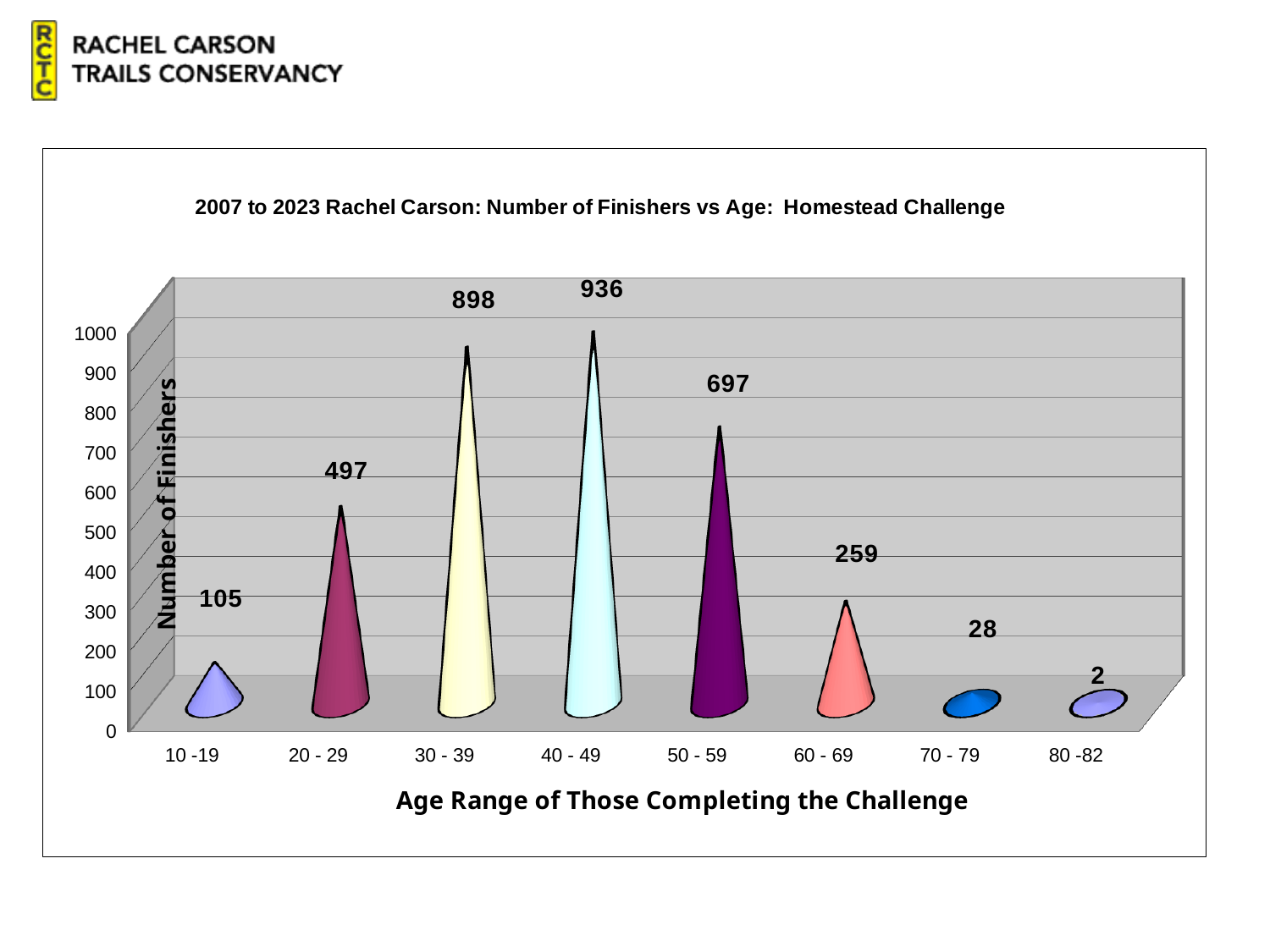
Do the number of finishers rise or fall from the 40 - 49 age range to the 80 -82 age range? fall What is the title of the chart? 2007 to 2023 Rachel Carson: Number of Finishers vs Age: Homestead Challenge Which age range has more finishers, 20 - 29 or 60 - 69? 20 - 29 How many age ranges are shown on the x axis? 8 What is the difference in finishers between the 40 - 49 and 50 - 59 age ranges? 239 Which age range has the lowest number of finishers? 80 -82 What is the number of finishers for the 60 - 69 age range? 259 What kind of chart is this? bar chart How many finishers were in the 30 - 39 age range? 898 How many finishers were in the 80 -82 age range? 2 Which age range has the highest number of finishers? 40 - 49 What is the difference in finishers between the 20 - 29 and 10 -19 age ranges? 392